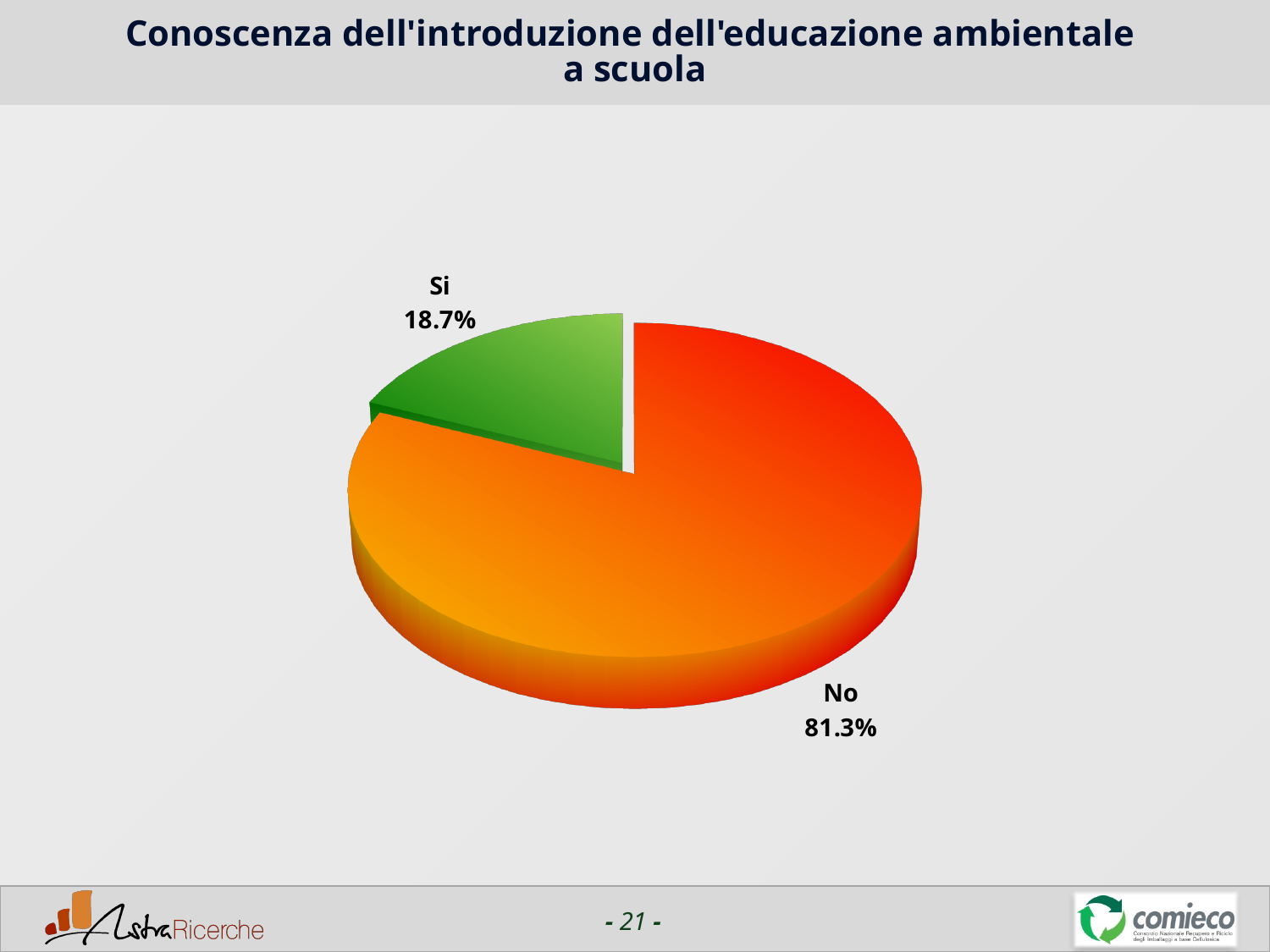
Which is larger, the "Si" slice or the "No" slice? No What colour is the "Si" slice? green Which slice is the smallest? Si What share of the pie does the "Si" slice represent? 18.7% What kind of chart is shown on the slide? pie chart How many slices does the pie chart have? 2 What is the title of the chart? Conoscenza dell'introduzione dell'educazione ambientale a scuola What is the difference between the "No" and "Si" values? 62.6% Which slice is the largest? No What is the value for the "No" slice? 81.3% What is the value for the "Si" slice? 18.7%